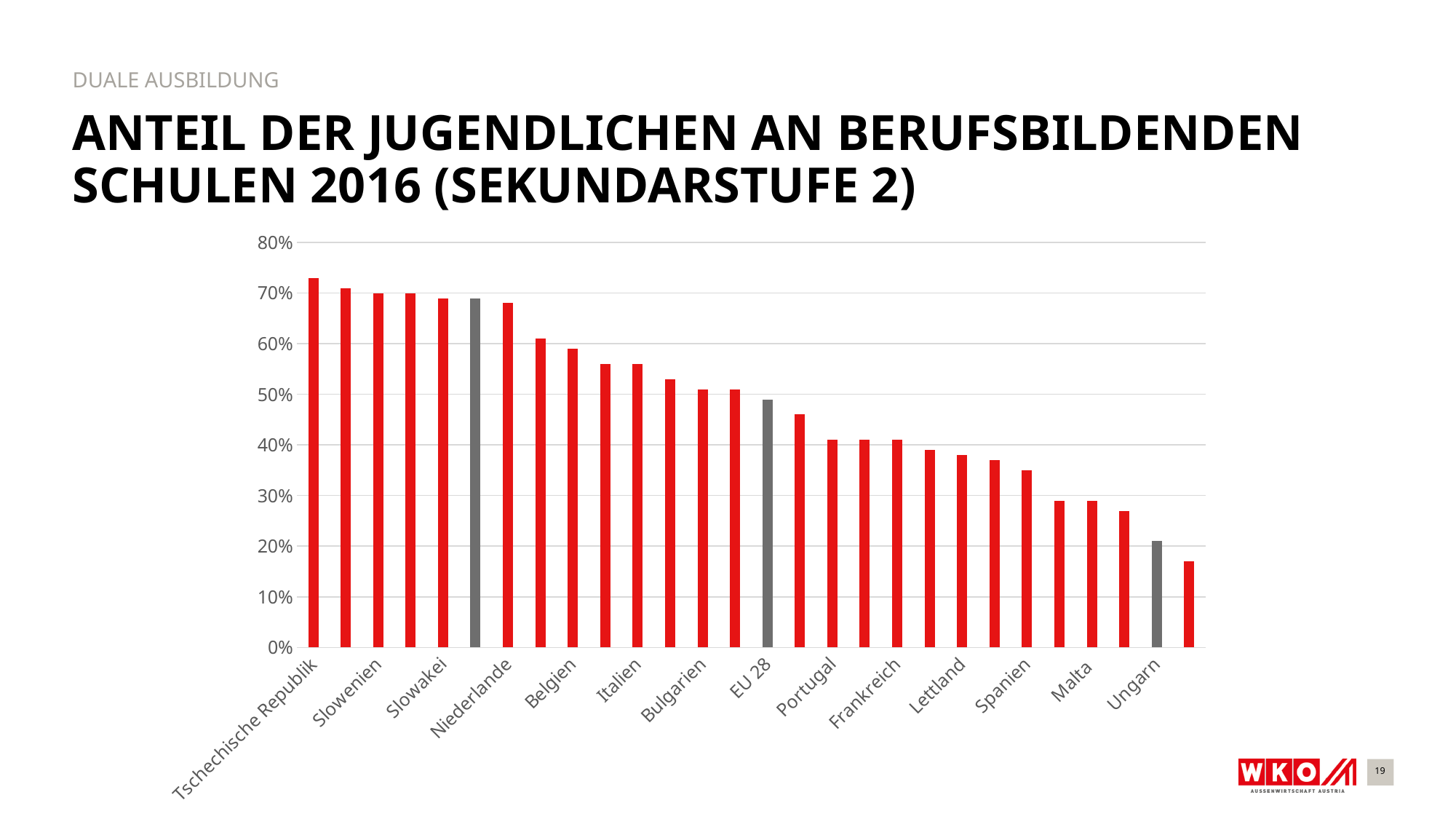
What is the title of the chart on the slide? Anteil der Jugendlichen an berufsbildenden Schulen 2016 (Sekundarstufe 2) Is the value for Spanien greater or less than 40%? less Is the value for Italien greater or less than 50%? greater What kind of chart is shown on the slide? bar chart Do the bar values rise or fall from left to right along the x axis? fall Is the value for Ungarn greater or less than 30%? less Which country has the highest share of young people in vocational schools in this chart? Tschechische Republik Which has a higher value, Belgien or Portugal? Belgien Which has a higher value, Malta or Niederlande? Niederlande